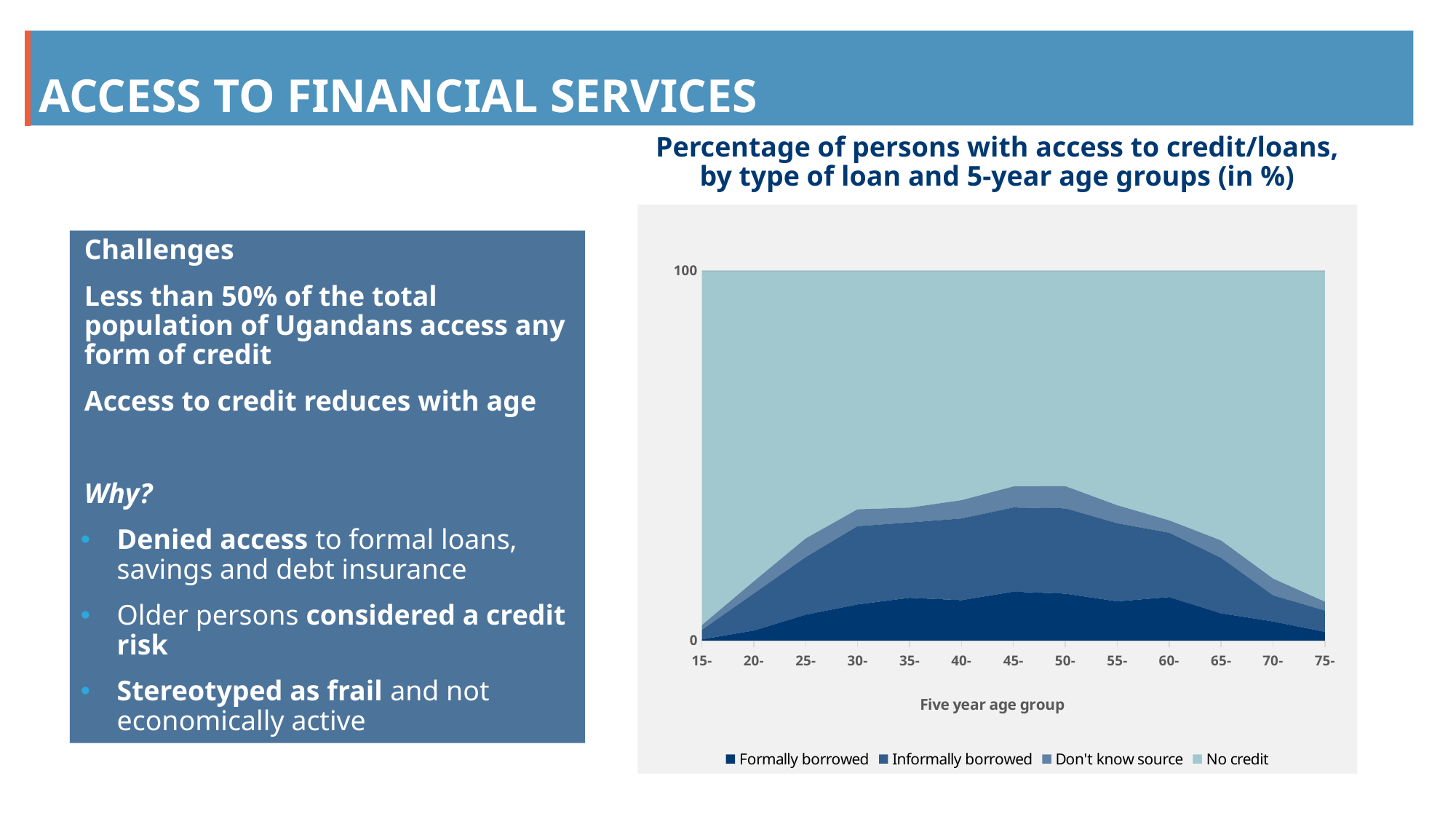
Which series occupies the largest area of the chart across all age groups? No credit From the 50- age group to the 75- age group, does the share of persons with any form of credit rise or fall? Fall Is the 'No credit' share larger for the 15- age group or the 45- age group? 15- What is the title of the chart? Percentage of persons with access to credit/loans, by type of loan and 5-year age groups (in %) How many five-year age groups are shown on the x axis of the chart? 13 What kind of chart is shown on the slide? Stacked area chart What is the highest value printed on the y axis of the chart? 100 Which age group has the smallest share of persons with any form of credit (formal, informal or unknown source)? 15- From the 15- age group to the 30- age group, does the share of persons with any form of credit rise or fall? Rise What is the label of the x axis of the chart? Five year age group How many series does the chart's legend list? 4 Is the 'Formally borrowed' share larger for the 45- age group or the 75- age group? 45-